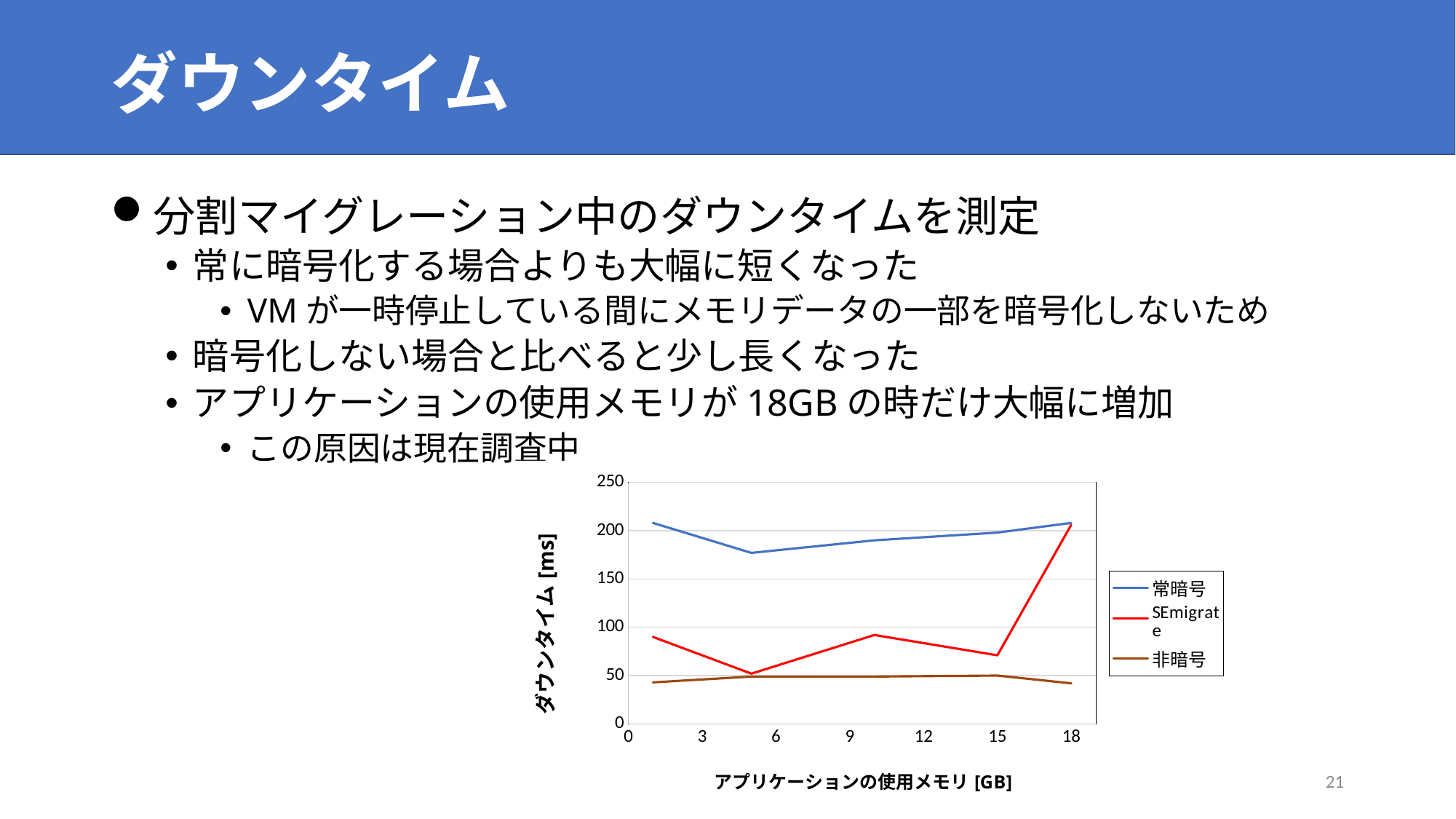
Is the value for 非暗号 at around 15 GB greater or less than 100? less How many series does the chart legend list? 3 Is the value for SEmigrate at 18 GB greater or less than 150? greater How many data points does the SEmigrate series have? 5 Is the value for SEmigrate at around 5 GB greater or less than 100? less What is the label of the y axis of the chart? ダウンタイム [ms] What kind of chart is shown on the slide? line chart Does the SEmigrate line rise or fall between 15 GB and 18 GB? rise Which series is drawn in red in the chart? SEmigrate At around 10 GB, which series has the larger value, 常暗号 or SEmigrate? 常暗号 At around 15 GB, which series has the larger value, SEmigrate or 非暗号? SEmigrate